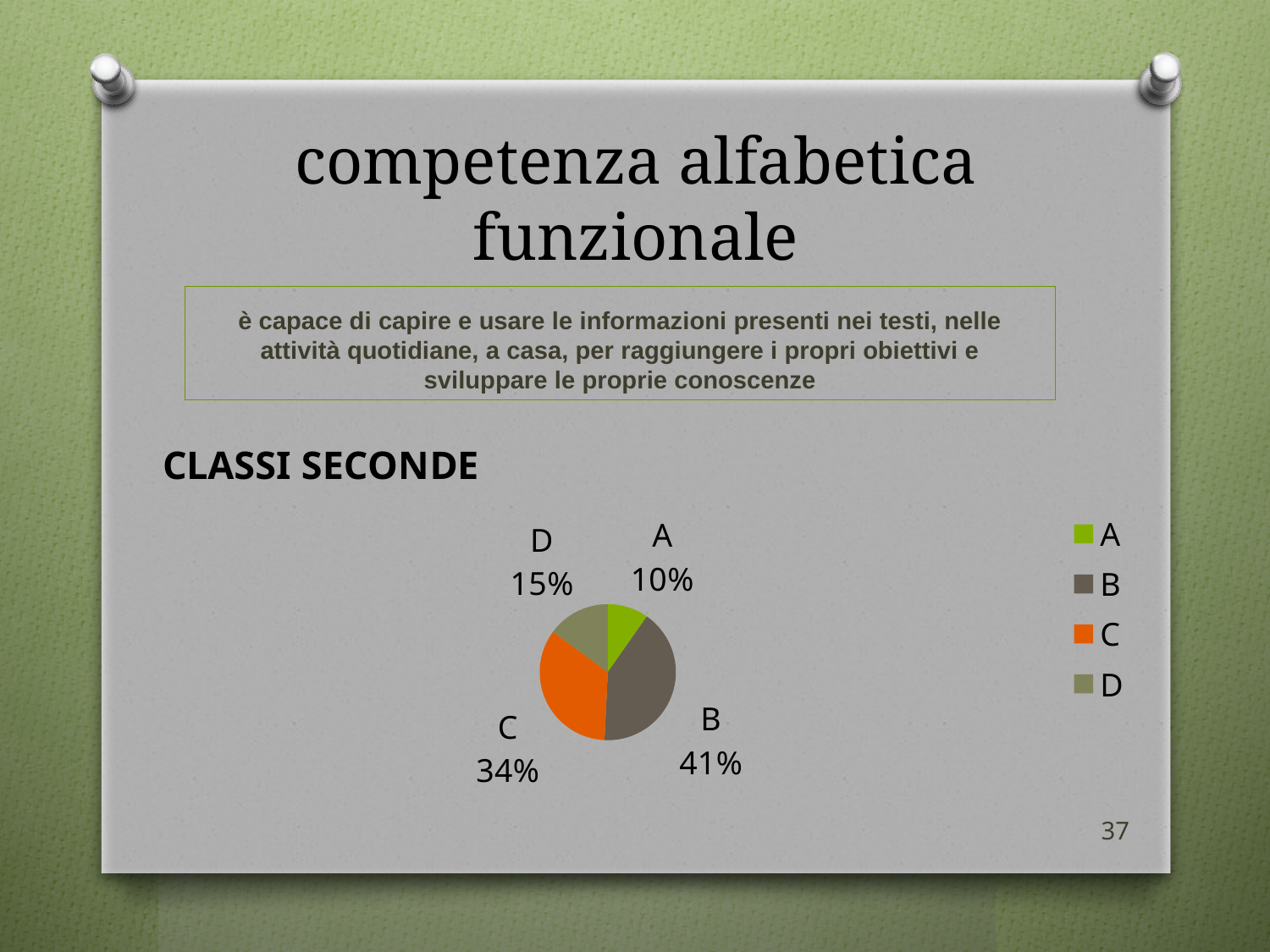
What percentage does slice C represent in the pie chart? 34% Which category has the smallest share of the pie chart? A What is the difference in percentage points between slice B and slice C? 7 How many entries does the legend list? 4 Which is larger, the share for D or the share for A? D What colour is the slice for category C in the pie chart? orange How many slices does the pie chart have? 4 What percentage does slice D represent in the pie chart? 15% What percentage does slice A represent in the pie chart? 10% What percentage does slice B represent in the pie chart? 41% Which category has the largest share of the pie chart? B What kind of chart is shown on the slide? pie chart